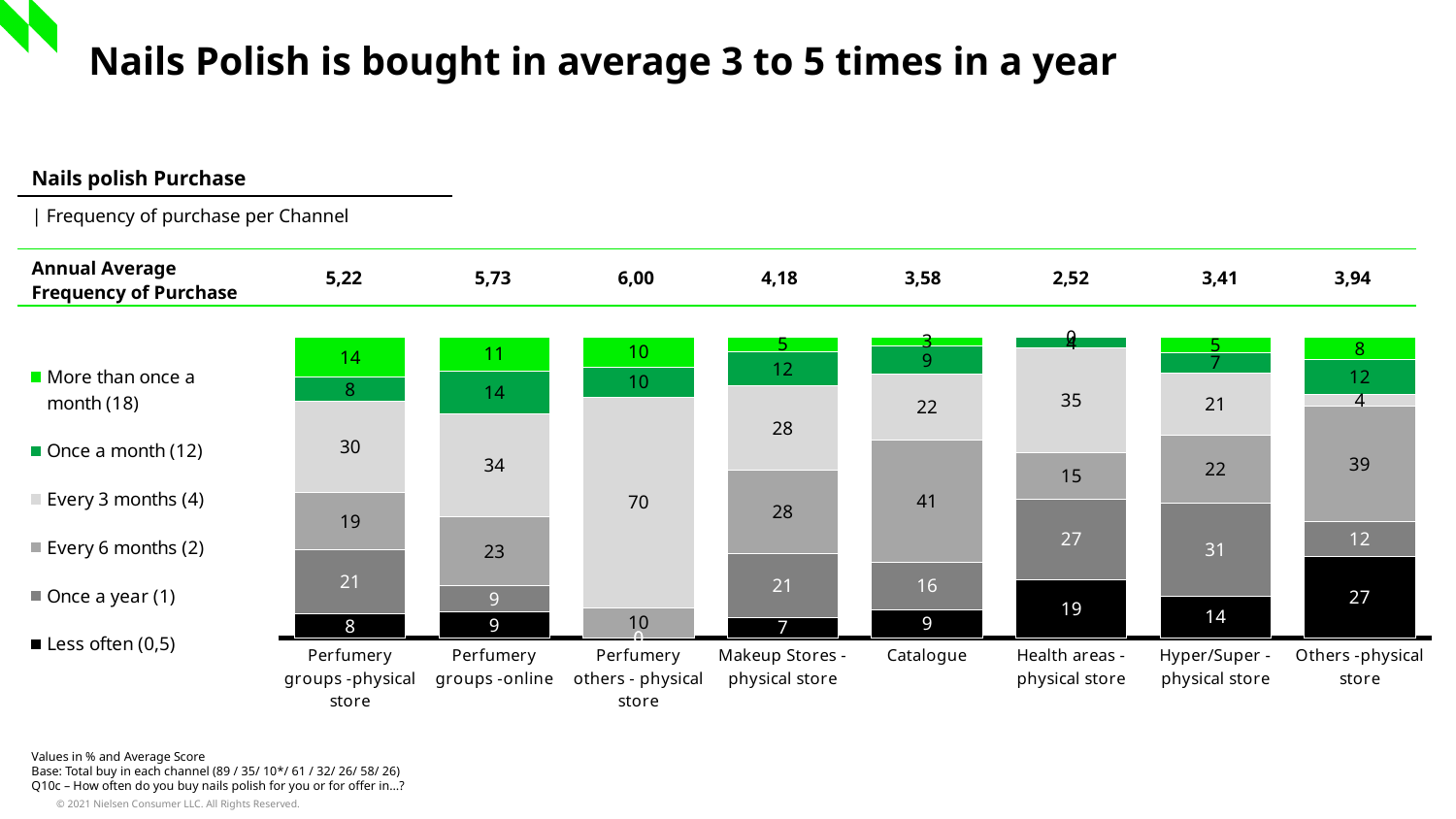
Which has a larger 'Every 3 months' value: Perfumery groups - online or Perfumery groups - physical store? Perfumery groups - online What kind of chart is shown on the slide? Stacked bar chart How many channels (categories) are shown along the x axis of the chart? 8 Which channel has the lowest Annual Average Frequency of Purchase? Health areas - physical store What is the Annual Average Frequency of Purchase for Catalogue? 3,58 Which channel has the highest Annual Average Frequency of Purchase? Perfumery others - physical store What is the value for 'Every 6 months' in the Catalogue channel? 41 How many series does the chart legend list? 6 Which legend entry is represented by the black segments at the bottom of the bars? Less often (0,5) What is the value for 'Less often' in the Others - physical store channel? 27 What percentage of buyers in Perfumery others - physical store purchase nail polish every 3 months? 70 What is the difference between the 'Once a year' value for Hyper/Super - physical store and for Perfumery groups - online? 22